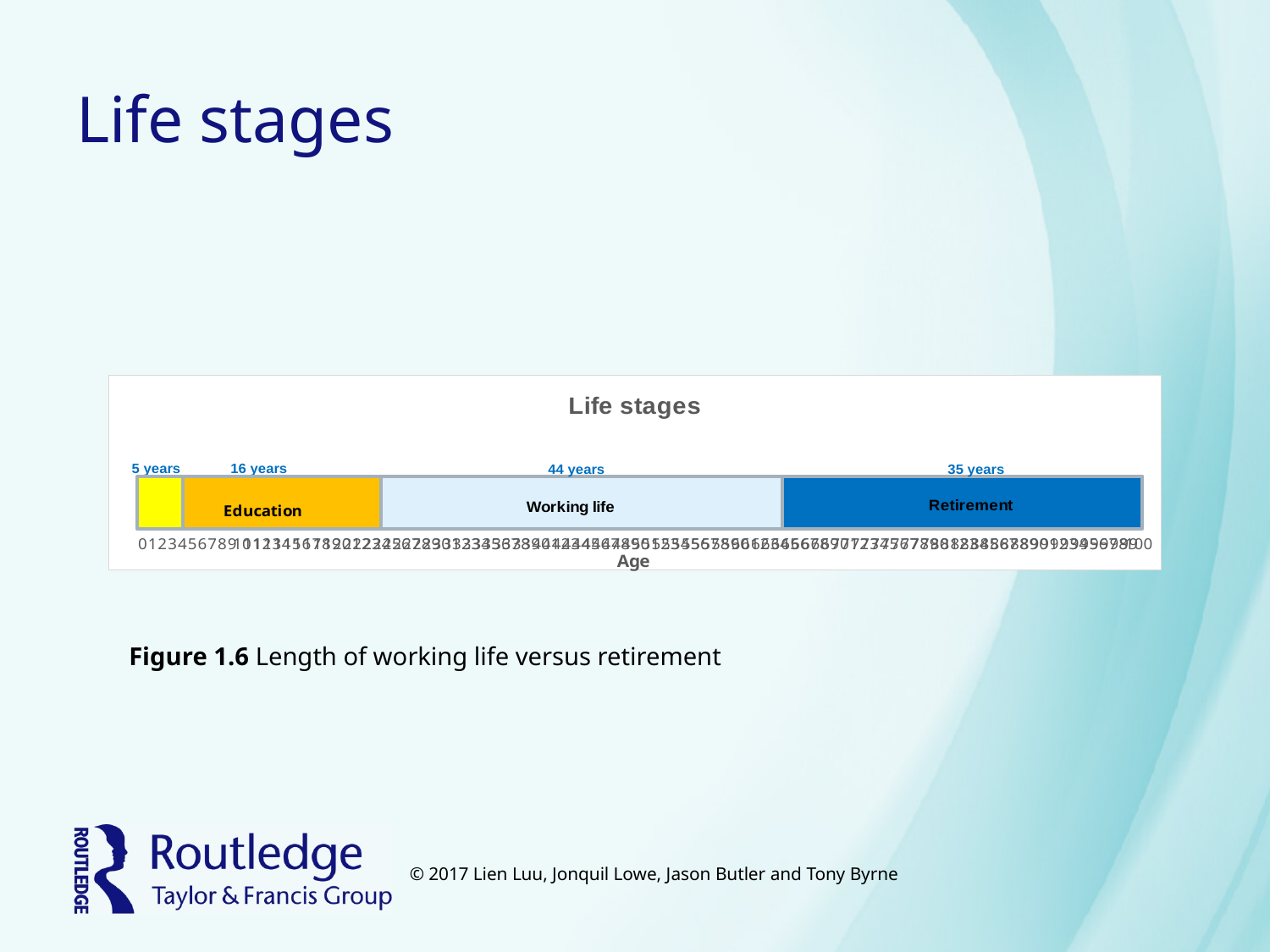
How many years longer is Working life than Retirement in the Life stages chart? 9 years Which is shorter in the Life stages chart, Education or Retirement? Education How many segments make up the stacked bar in the Life stages chart? 4 Which is longer in the Life stages chart, Working life or Retirement? Working life Which life stage is the longest in the Life stages chart? Working life What is the total length in years of all the segments in the Life stages bar? 100 years How many years does the Retirement segment represent in the Life stages chart? 35 years What is the title of the horizontal axis in the Life stages chart? Age How many years longer is Retirement than Education in the Life stages chart? 19 years What kind of chart is the Life stages chart? Stacked bar chart How many years does the Education segment represent in the Life stages chart? 16 years What is the length of the Working life segment in the Life stages chart? 44 years